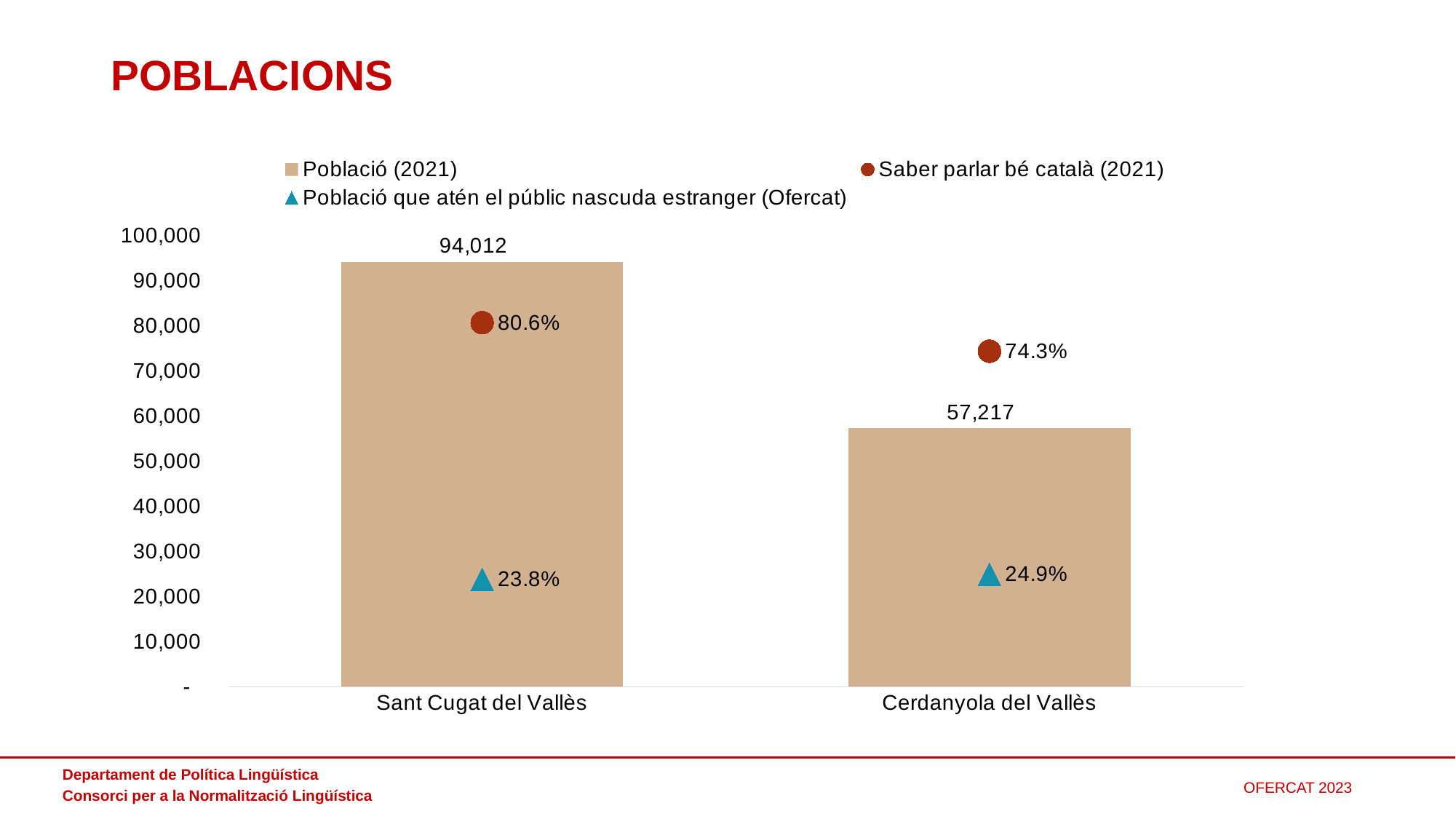
What is the Població (2021) value for Sant Cugat del Vallès? 94,012 Which municipality has the higher Població (2021)? Sant Cugat del Vallès What is the Població que atén el públic nascuda estranger (Ofercat) value for Cerdanyola del Vallès? 24.9% How many municipalities are shown on the x axis? 2 Which municipality has the higher Saber parlar bé català (2021) percentage? Sant Cugat del Vallès What is the Població (2021) value for Cerdanyola del Vallès? 57,217 What is the Saber parlar bé català (2021) value for Sant Cugat del Vallès? 80.6% What is the difference in Població (2021) between Sant Cugat del Vallès and Cerdanyola del Vallès? 36,795 What is the Saber parlar bé català (2021) value for Cerdanyola del Vallès? 74.3% How many series does the legend list? 3 What is the title of the slide? POBLACIONS What is the Població que atén el públic nascuda estranger (Ofercat) value for Sant Cugat del Vallès? 23.8%